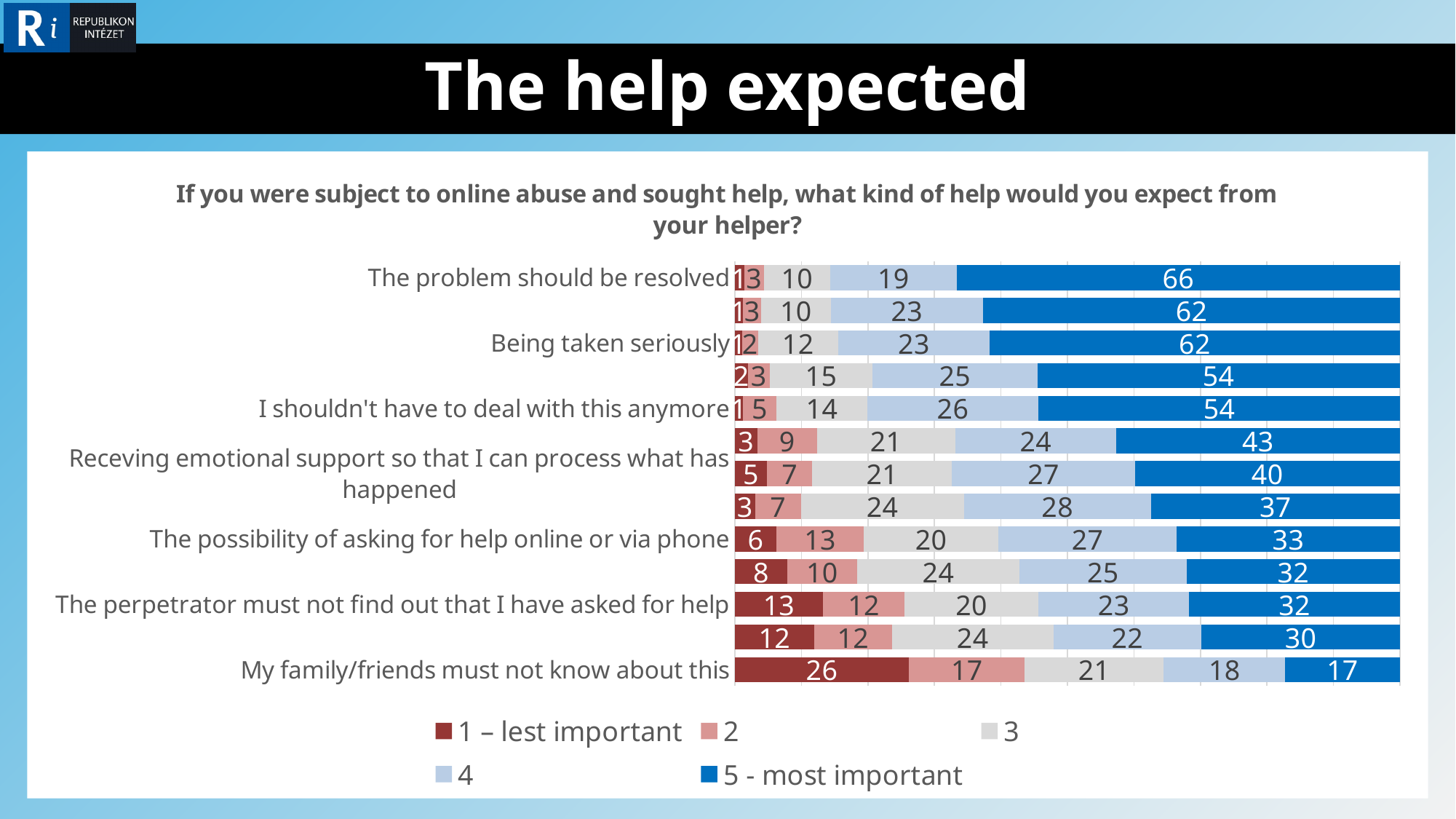
How many series does the legend list? 5 Which labelled category has the lowest value for "5 - most important"? My family/friends must not know about this How many bars are plotted in the chart? 13 What is the total of the stacked bar for "My family/friends must not know about this"? 99 What is the value for "5 - most important" for "My family/friends must not know about this"? 17 What is the difference between the "5 - most important" values for "The problem should be resolved" and "Being taken seriously"? 4 Which has the larger value for "4": "Receiving emotional support so that I can process what has happened" or "Being taken seriously"? Receiving emotional support so that I can process what has happened Which labelled category has the highest value for "5 - most important"? The problem should be resolved What is the value for "5 - most important" for "The problem should be resolved"? 66 What is the value for "3" for "The perpetrator must not find out that I have asked for help"? 20 What kind of chart is shown on the slide? Stacked bar chart What is the value for "1 – lest important" for "My family/friends must not know about this"? 26